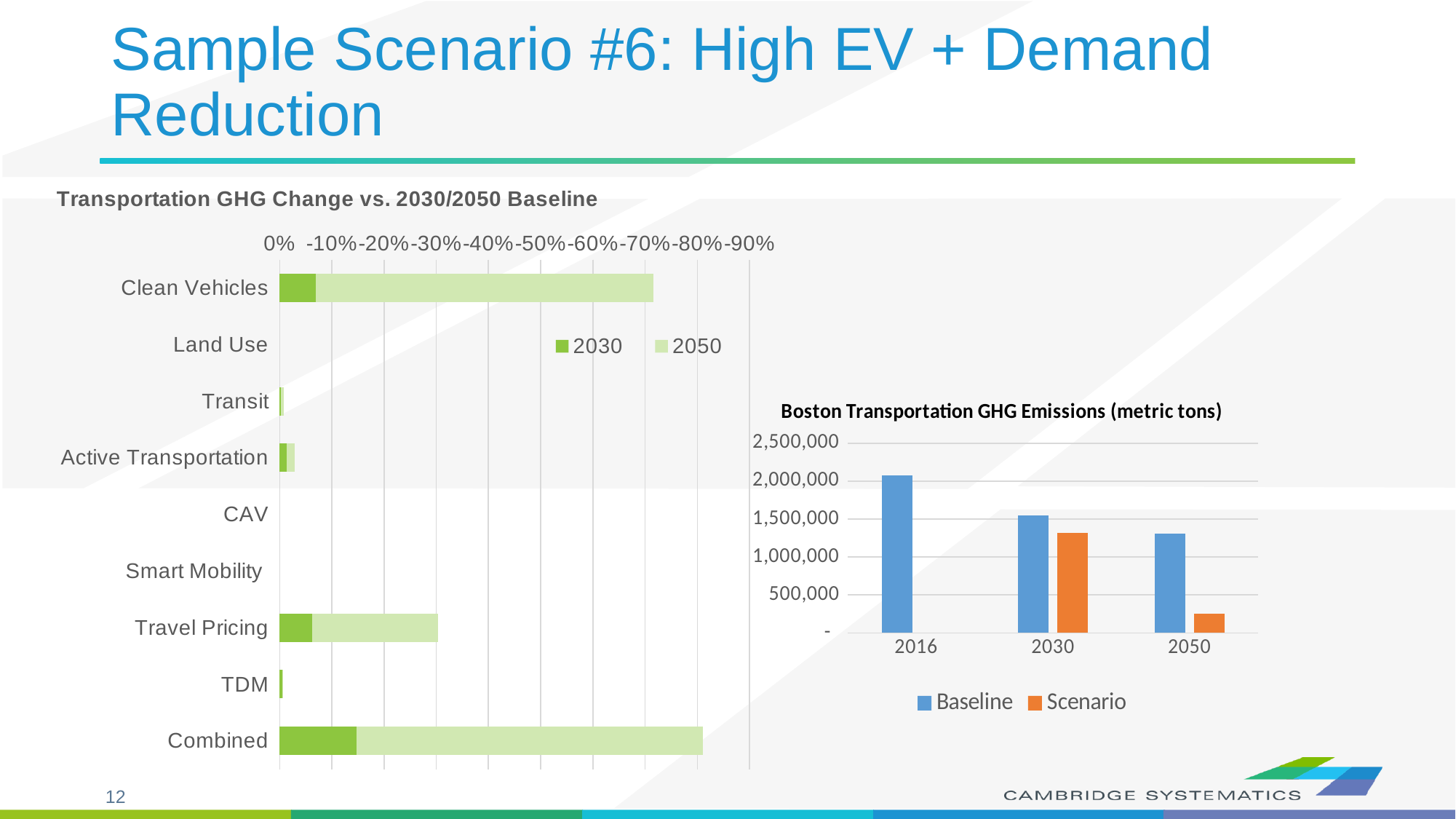
How many series does the legend of the 'Transportation GHG Change vs. 2030/2050 Baseline' chart list? 2 What are the legend entries on the 'Transportation GHG Change vs. 2030/2050 Baseline' chart? 2030 and 2050 What kind of chart is the 'Transportation GHG Change vs. 2030/2050 Baseline' chart? bar chart How many categories are listed on the 'Transportation GHG Change vs. 2030/2050 Baseline' chart? 9 What kind of chart is the 'Boston Transportation GHG Emissions (metric tons)' chart? bar chart On the 'Boston Transportation GHG Emissions (metric tons)' chart, is the Scenario value for 2050 greater or less than 500,000? less On the 'Transportation GHG Change vs. 2030/2050 Baseline' chart, which category has the longest 2050 bar? Combined On the 'Boston Transportation GHG Emissions (metric tons)' chart, do the Baseline values rise or fall from 2016 to 2050? fall On the 'Transportation GHG Change vs. 2030/2050 Baseline' chart, does the 2050 bar for Combined extend past the -70% gridline? yes On the 'Transportation GHG Change vs. 2030/2050 Baseline' chart, which has the longer 2050 bar, Travel Pricing or Clean Vehicles? Clean Vehicles How many series does the legend of the 'Boston Transportation GHG Emissions (metric tons)' chart list? 2 How many years are shown on the x axis of the 'Boston Transportation GHG Emissions (metric tons)' chart? 3